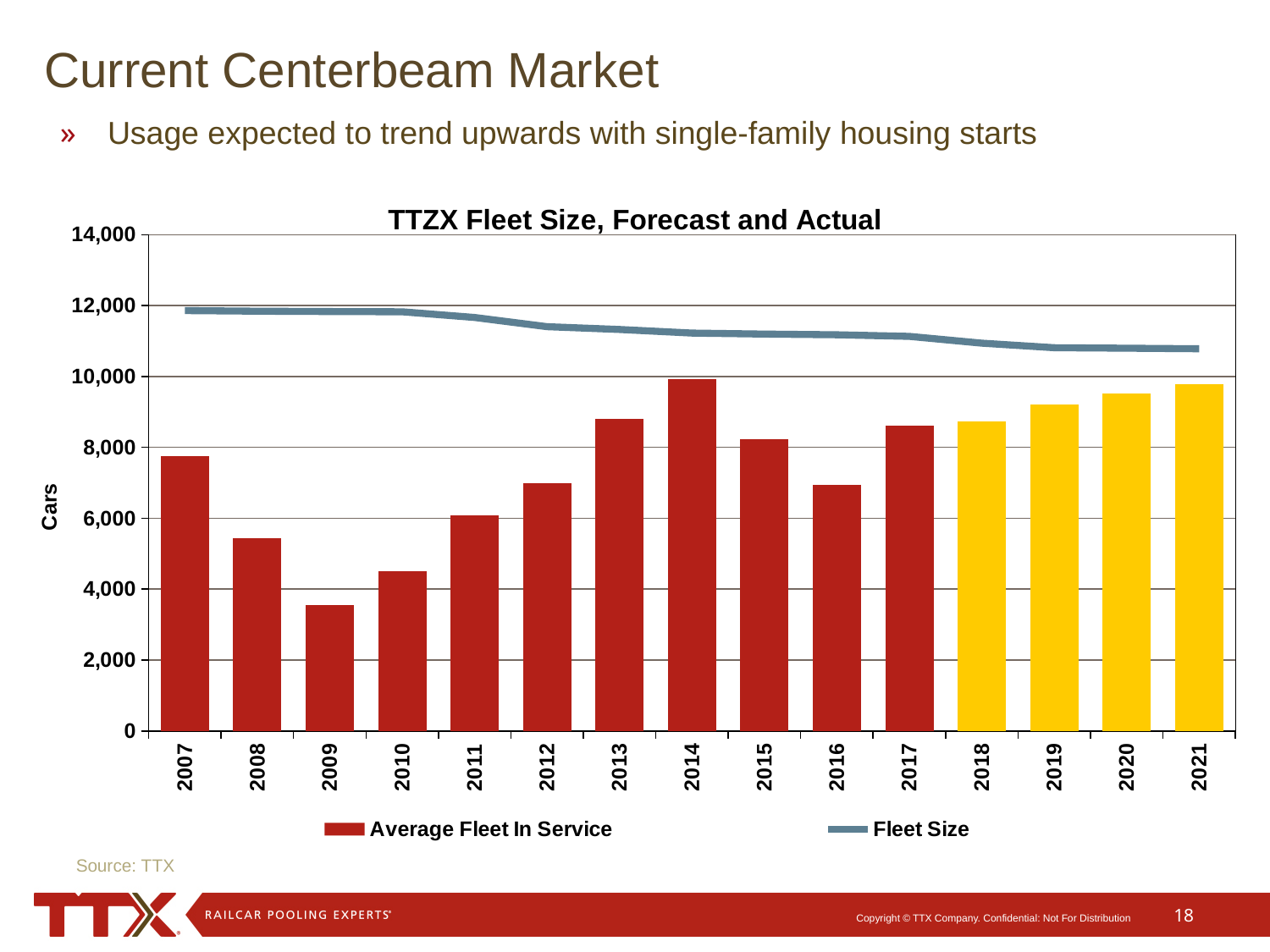
Is the Average Fleet In Service value for 2009 greater or less than 4,000? less What is the label on the vertical axis of the chart? Cars Is the Average Fleet In Service value for 2016 greater or less than 8,000? less Which is larger, the Average Fleet In Service bar for 2013 or for 2016? 2013 Is the Average Fleet In Service value for 2008 greater or less than 6,000? less Which year has the lowest Average Fleet In Service bar? 2009 How many series does the chart legend list? 2 Which is larger, the Average Fleet In Service bar for 2007 or for 2008? 2007 What is the title of the chart? TTZX Fleet Size, Forecast and Actual How many years are shown on the x axis of the chart? 15 Does the Fleet Size line rise or fall from 2007 to 2021? fall